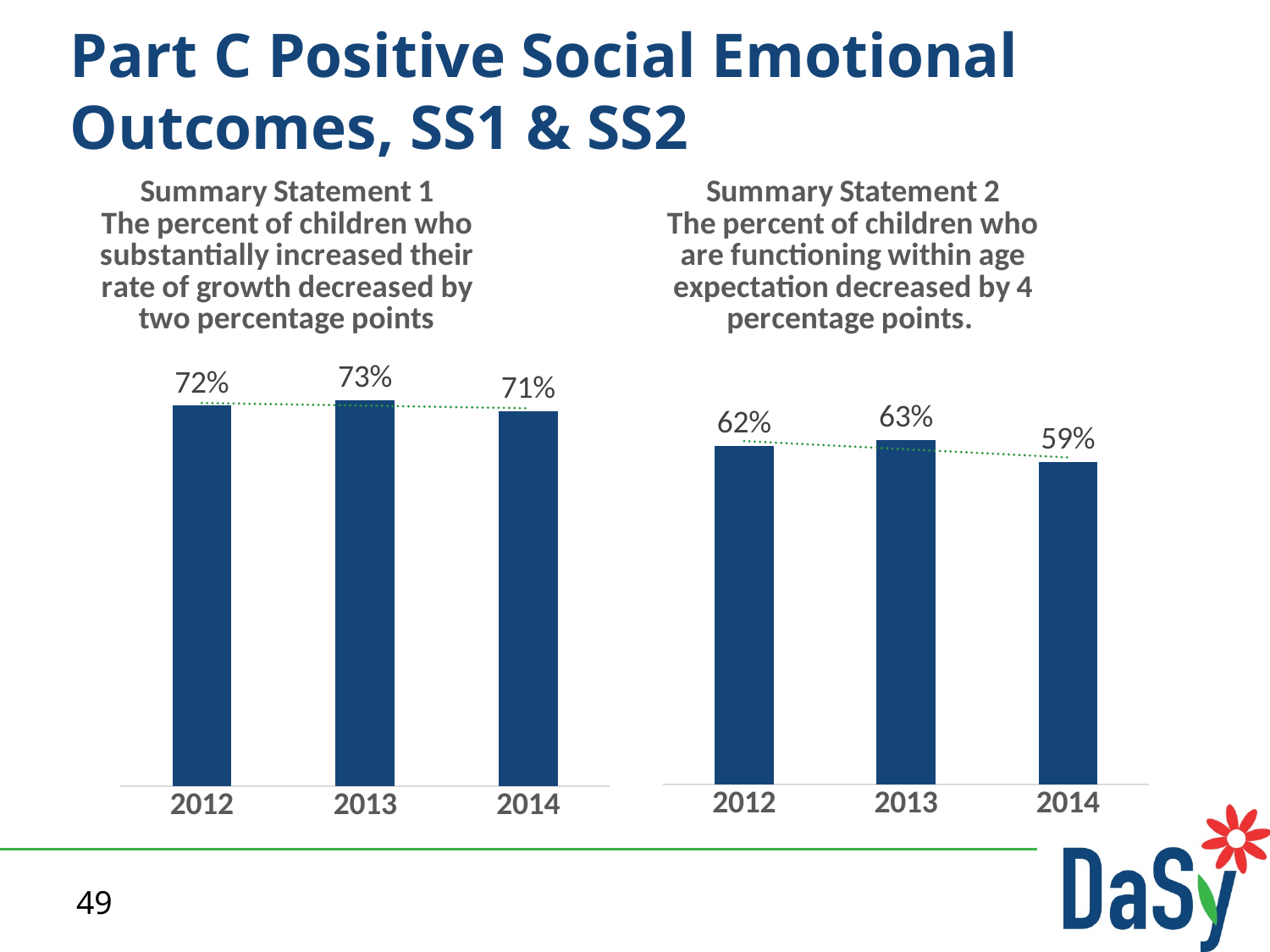
How many charts are shown on the slide? 2 How many years are shown in the Summary Statement 1 chart? 3 In the Summary Statement 1 chart, what is the value for 2013? 73% In the Summary Statement 1 chart, which year has the lowest value? 2014 In the Summary Statement 2 chart, does the value rise or fall from 2013 to 2014? Fall What kind of chart is the Summary Statement 2 chart? Bar chart In the Summary Statement 2 chart, what is the value for 2014? 59% In the Summary Statement 2 chart, which is larger, the value for 2012 or the value for 2014? 2012 In the Summary Statement 2 chart, which year has the highest value? 2013 In the Summary Statement 2 chart, what is the difference between the 2013 and 2014 values? 4 percentage points In the Summary Statement 1 chart, what is the difference between the 2013 and 2014 values? 2 percentage points In the Summary Statement 1 chart, what is the value for 2012? 72%